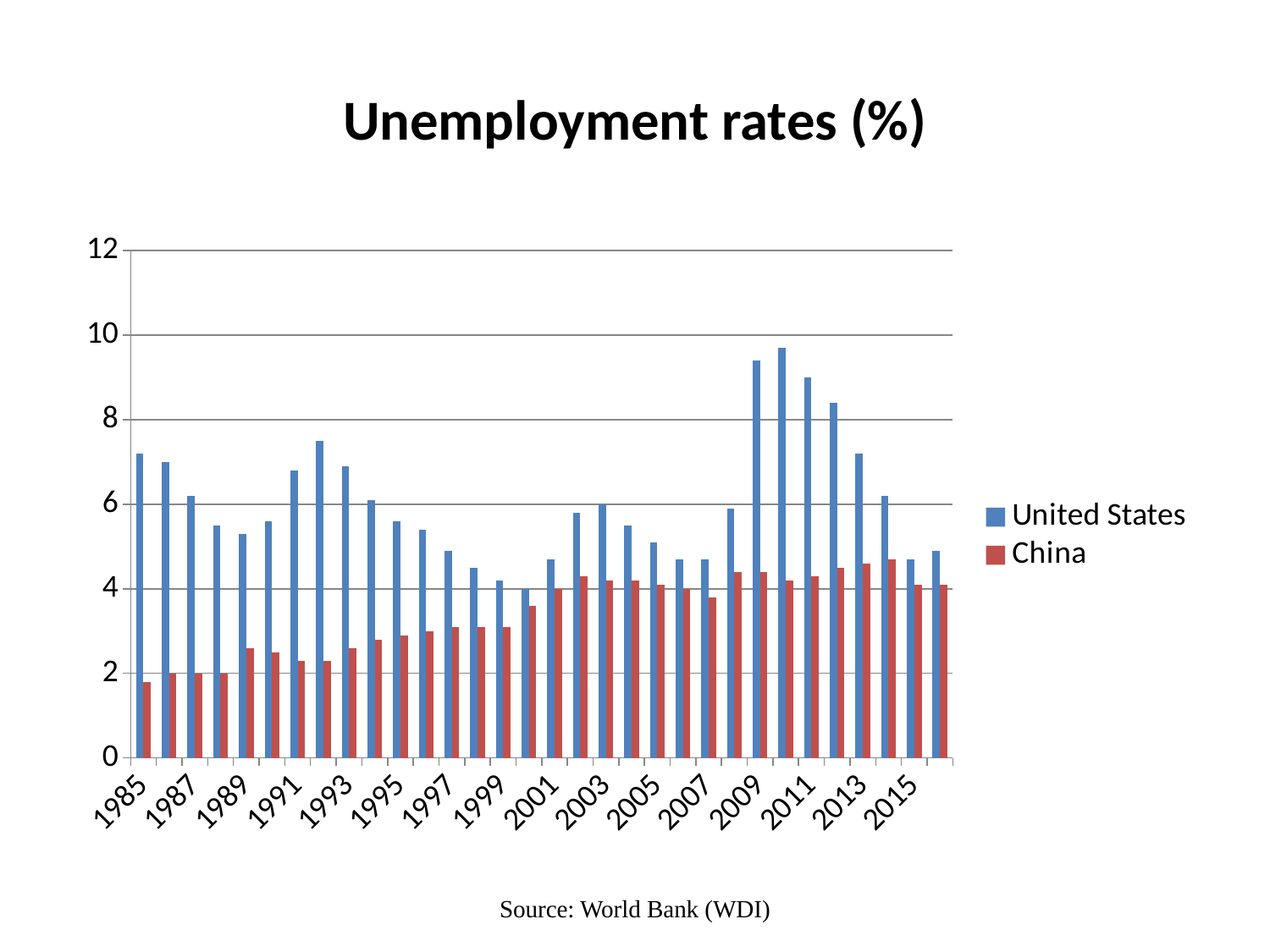
What kind of chart is shown on the slide? Bar chart In 2010, which is larger, the United States value or the China value? United States In which year is the United States unemployment rate highest? 2010 For China, which is larger, the value for 1985 or the value for 2015? 2015 Which series is shown in red? China Is the United States value for 2010 greater or less than 8? greater Is the China value for 1991 greater or less than 4? less Is the United States value for 2000 greater or less than 6? less What is the title of the chart? Unemployment rates (%) Do the United States values rise or fall from 2010 to 2015? Fall How many series does the legend list? 2